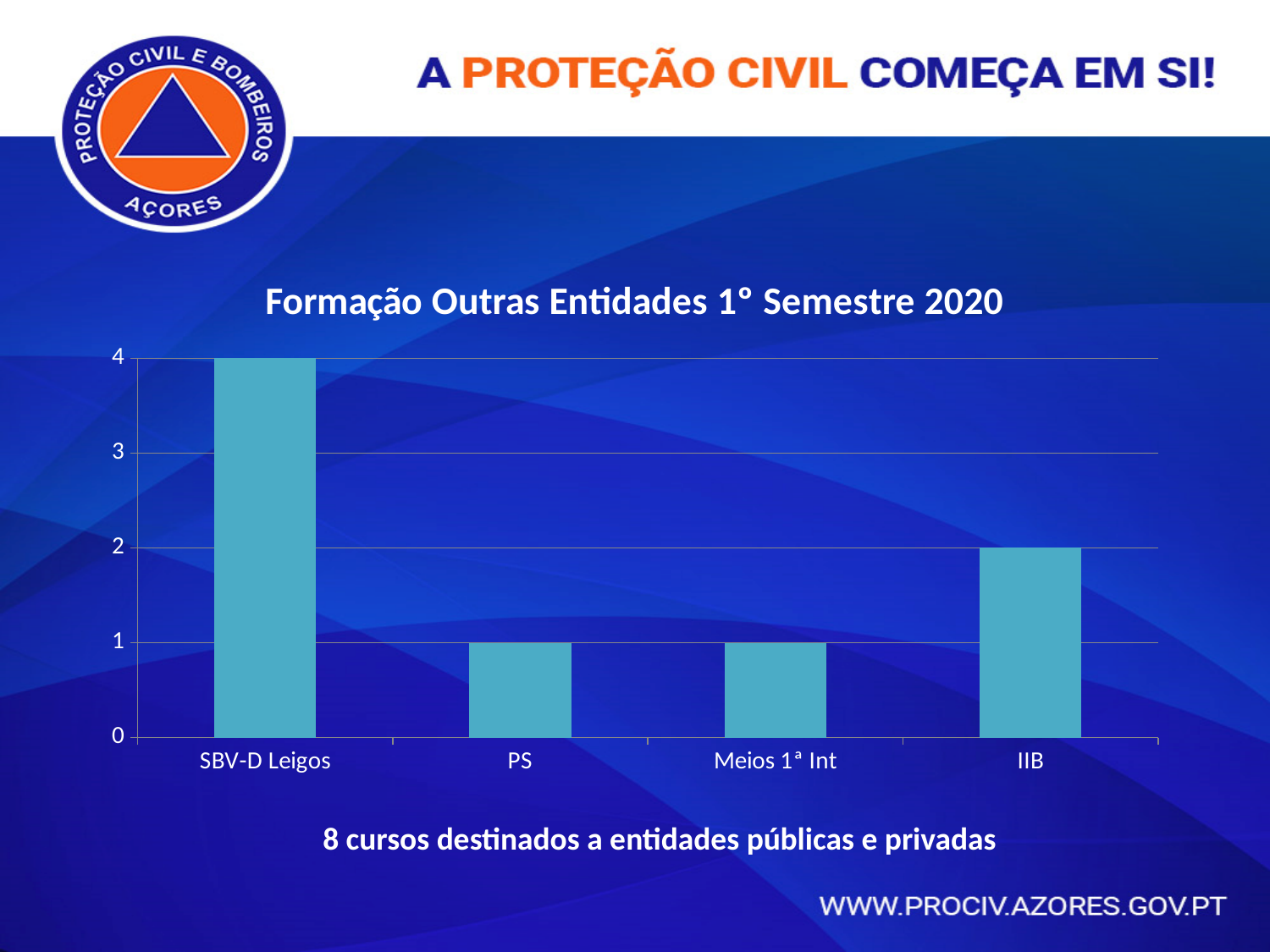
Is the value for SBV-D Leigos greater or less than 3? greater What is the title of the chart? Formação Outras Entidades 1º Semestre 2020 What is the value for SBV-D Leigos? 4 What is the value for Meios 1ª Int? 1 What is the difference between the values for SBV-D Leigos and IIB? 2 Which is larger, the value for IIB or the value for PS? IIB What is the value for PS? 1 What is the highest value shown on the y axis? 4 Which category has the highest value? SBV-D Leigos What kind of chart is shown on the slide? bar chart How many categories are shown on the x axis? 4 What is the value for IIB? 2